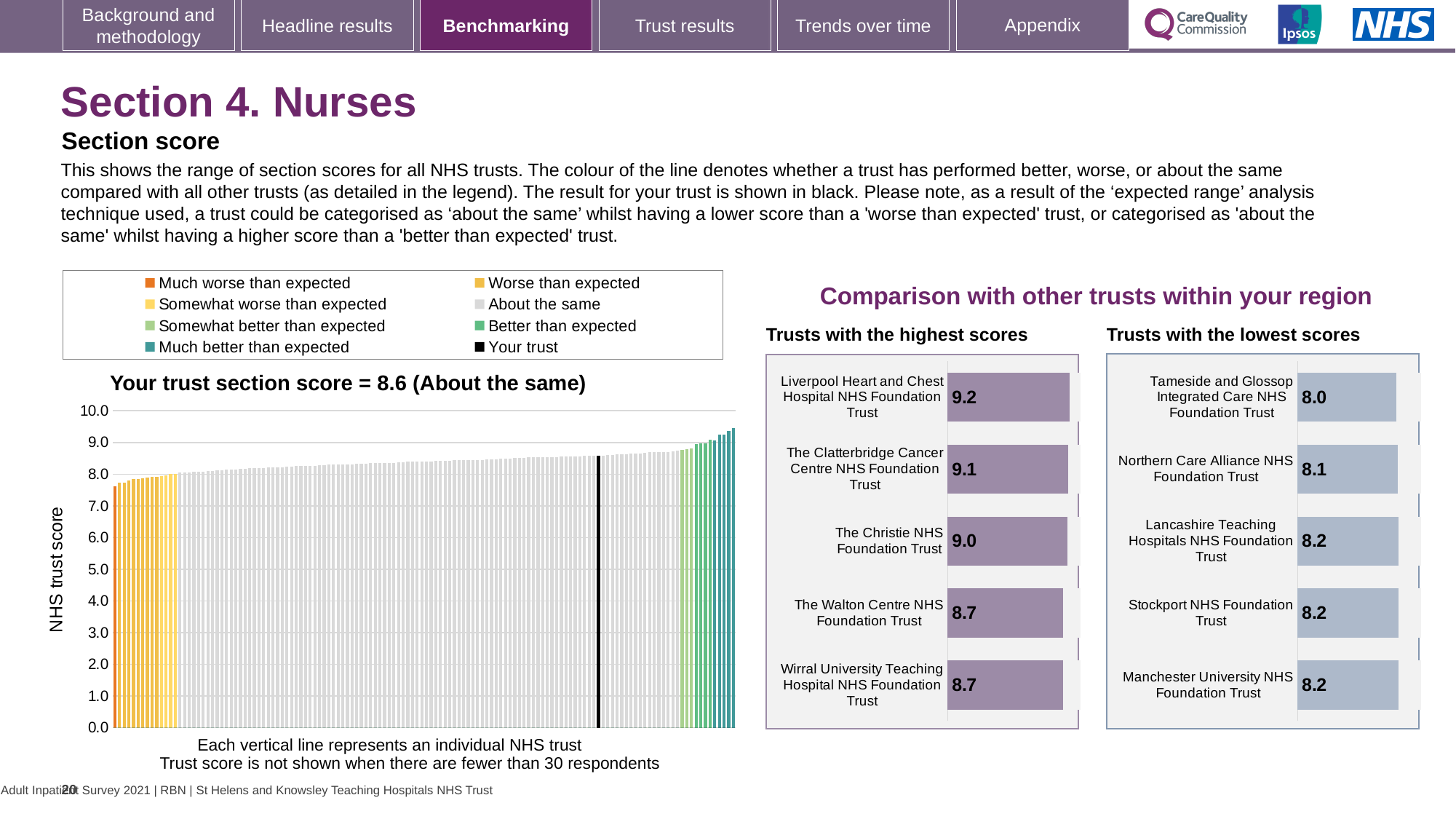
On the 'Your trust section score' chart, what kind of chart is shown? bar chart On the 'Trusts with the highest scores' chart, how many trusts are shown? 5 On the 'Trusts with the highest scores' chart, what is the score for The Christie NHS Foundation Trust? 9.0 On the 'Trusts with the highest scores' chart, which trust has the highest score? Liverpool Heart and Chest Hospital NHS Foundation Trust On the 'Your trust section score' chart, what is the section score for your trust? 8.6 On the 'Trusts with the lowest scores' chart, what is the score for Northern Care Alliance NHS Foundation Trust? 8.1 On the 'Trusts with the lowest scores' chart, which trust has the lowest score? Tameside and Glossop Integrated Care NHS Foundation Trust On the 'Trusts with the highest scores' chart, which has the higher score: The Clatterbridge Cancer Centre NHS Foundation Trust or The Walton Centre NHS Foundation Trust? The Clatterbridge Cancer Centre NHS Foundation Trust On the 'Trusts with the highest scores' chart, what is the difference between the scores of Liverpool Heart and Chest Hospital NHS Foundation Trust and The Christie NHS Foundation Trust? 0.2 On the 'Your trust section score' chart, do the trust scores rise or fall from left to right along the x axis? rise On the 'Your trust section score' chart, how many entries does the legend list? 8 On the 'Your trust section score' chart, what is the label of the vertical axis? NHS trust score